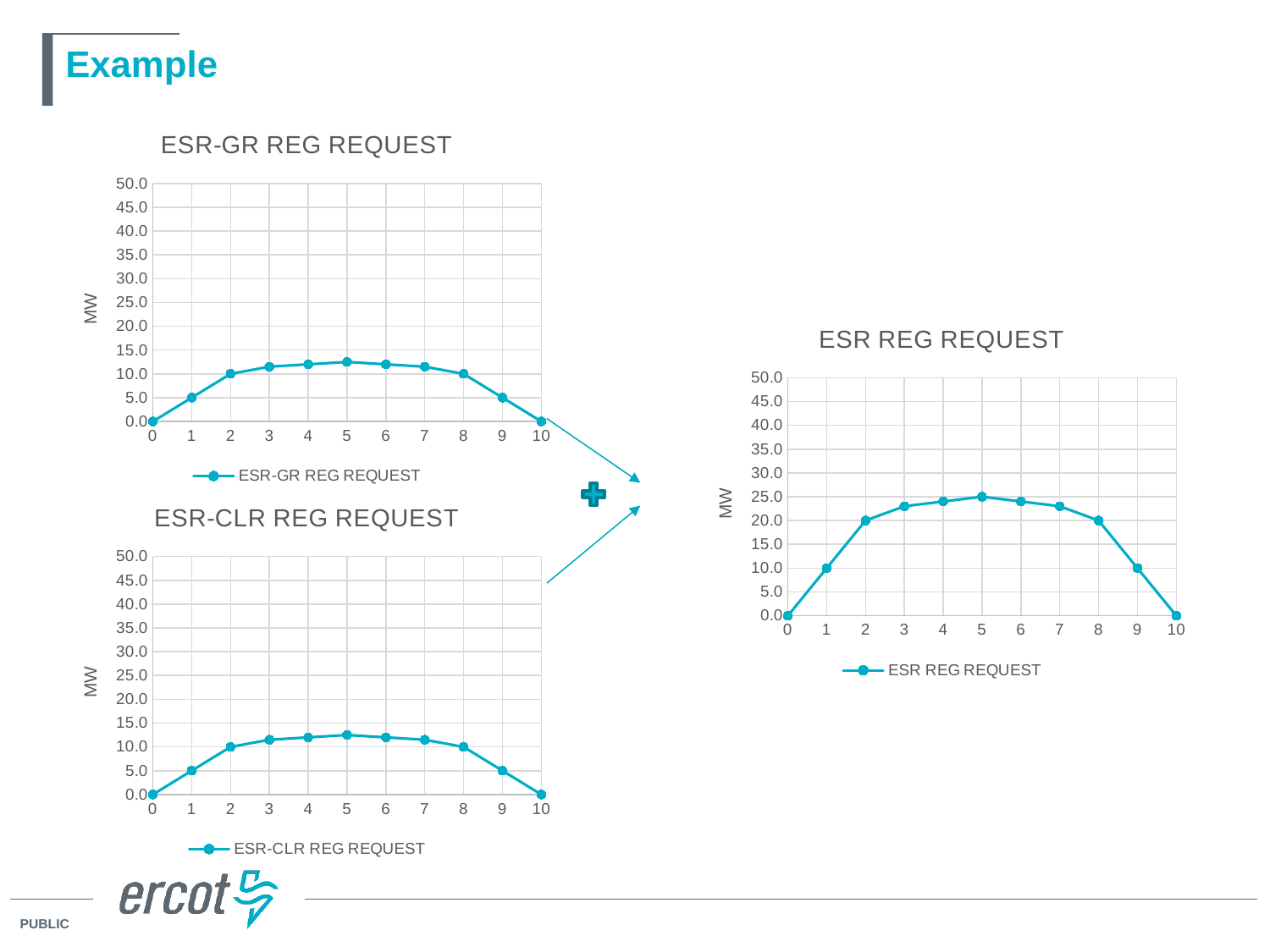
In the ESR-GR REG REQUEST chart, is the value at x = 5 greater or less than 10.0? greater In the ESR REG REQUEST chart, what is the value at x = 5? 25.0 What kind of chart is the ESR-GR REG REQUEST chart? line chart How many data points are plotted in the ESR-CLR REG REQUEST chart? 11 What is the y-axis label on the ESR REG REQUEST chart? MW In the ESR-CLR REG REQUEST chart, what is the value at x = 9? 5.0 In the ESR REG REQUEST chart, is the value at x = 5 larger than the value at x = 1? yes In the ESR-GR REG REQUEST chart, what is the value at x = 2? 10.0 In the ESR-GR REG REQUEST chart, at which x value is the line highest? 5 In the ESR REG REQUEST chart, what is the value at x = 2? 20.0 In the ESR-GR REG REQUEST chart, what is the value at x = 0? 0.0 In the ESR-CLR REG REQUEST chart, is the value at x = 4 greater or less than 15.0? less